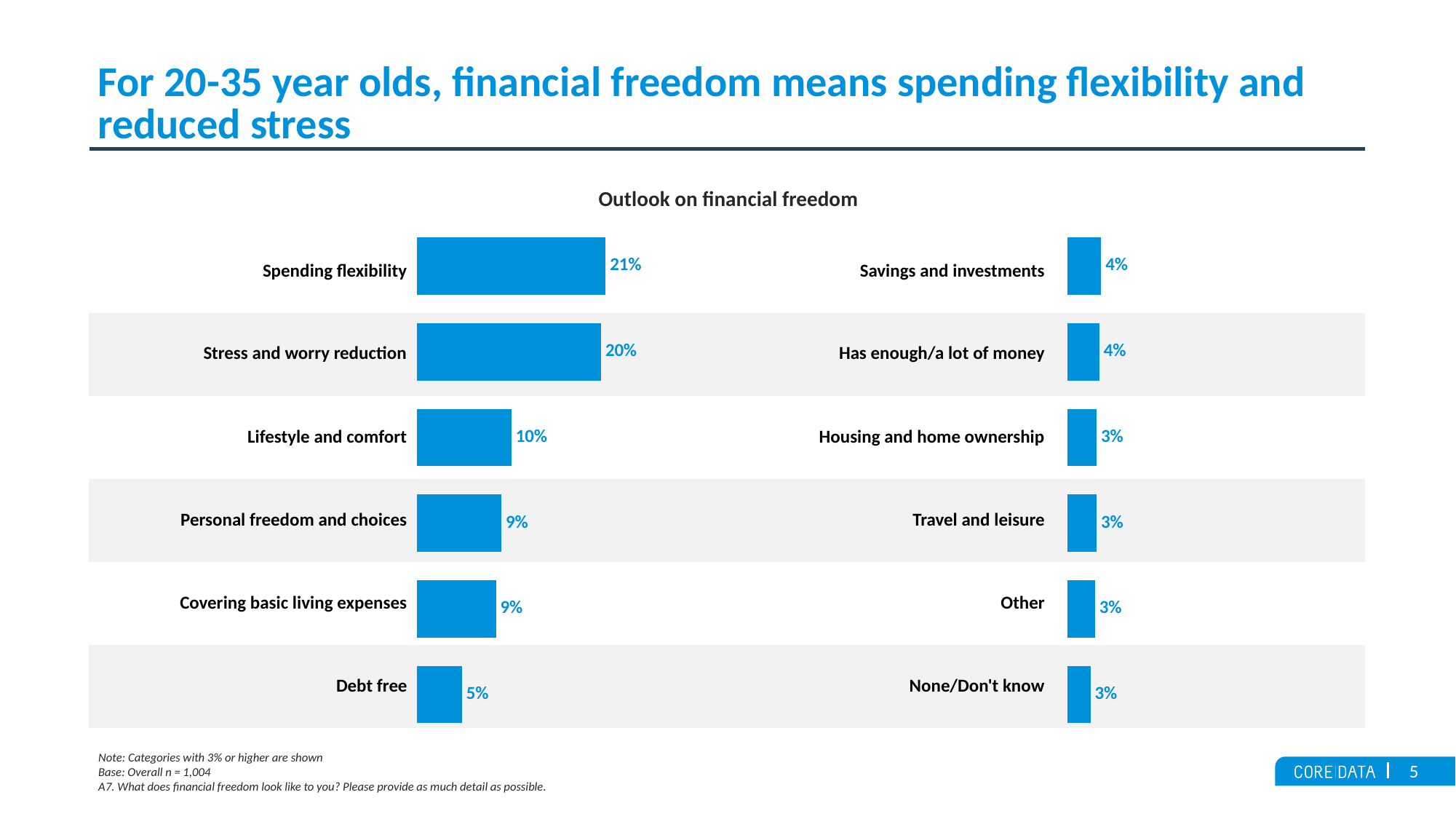
Which category has the highest value? Spending flexibility Which is larger, the value for Personal freedom and choices or the value for Debt free? Personal freedom and choices What is the value for Spending flexibility? 21% What kind of chart is shown on the slide? Bar chart What is the value for Stress and worry reduction? 20% What is the difference between the values for Spending flexibility and Lifestyle and comfort? 11% What is the difference between the values for Debt free and Has enough/a lot of money? 1% What is the value for Lifestyle and comfort? 10% What is the value for Housing and home ownership? 3% How many categories are shown in the chart? 12 What is the value for Savings and investments? 4% What is the value for Debt free? 5%